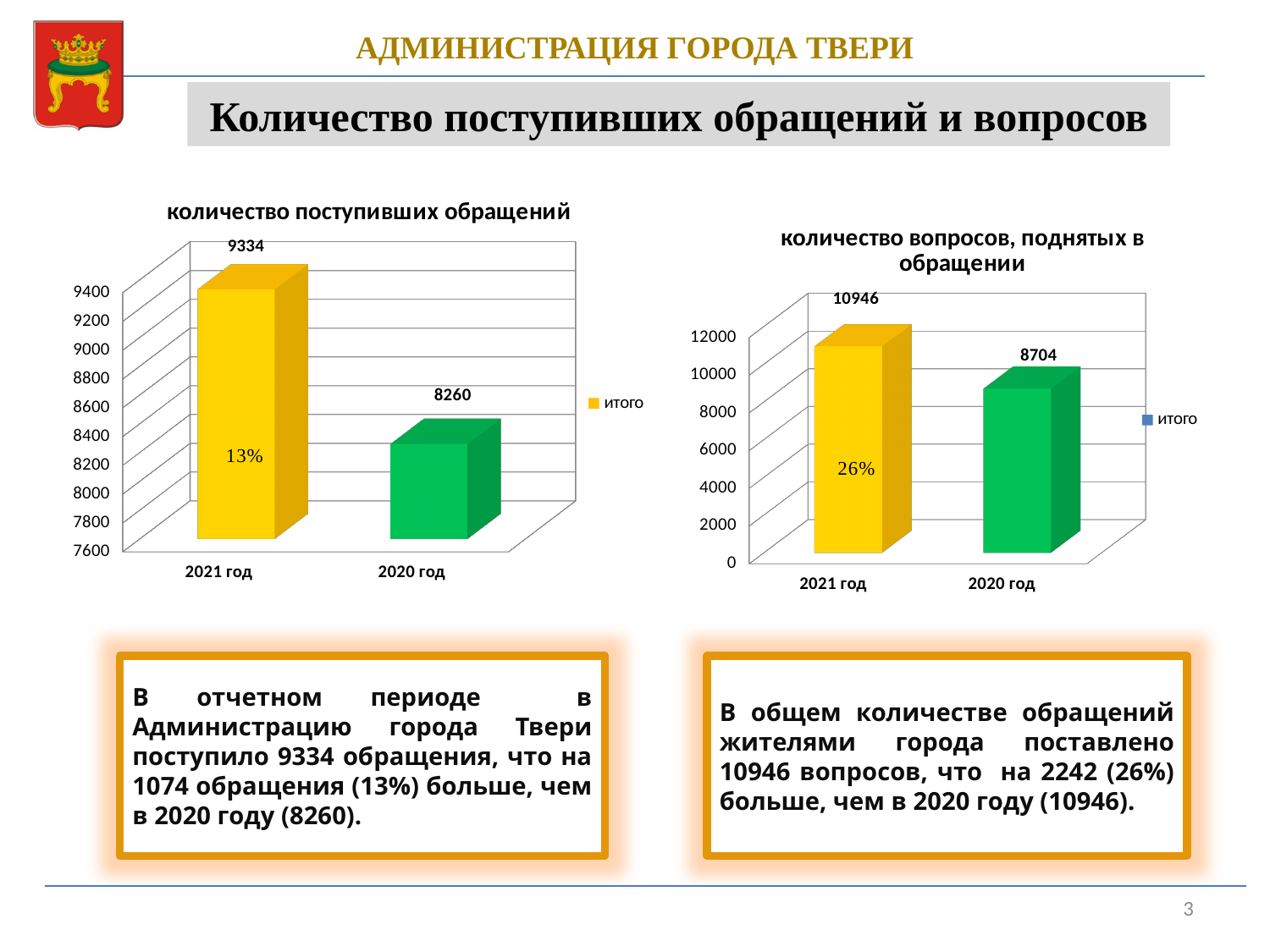
In the chart titled "количество поступивших обращений", what is the value for 2020 год? 8260 In the chart titled "количество вопросов, поднятых в обращении", what is the value for 2021 год? 10946 In the chart titled "количество вопросов, поднятых в обращении", what is the value for 2020 год? 8704 In the chart titled "количество поступивших обращений", which year has the higher value? 2021 год In the chart titled "количество вопросов, поднятых в обращении", which year has the lower value? 2020 год How many categories are shown in the chart titled "количество поступивших обращений"? 2 In the chart titled "количество поступивших обращений", what is the difference between the values for 2021 год and 2020 год? 1074 What kind of chart is the chart titled "количество вопросов, поднятых в обращении"? bar chart In the chart titled "количество вопросов, поднятых в обращении", is the value for 2020 год greater or less than 10000? less In the chart titled "количество вопросов, поднятых в обращении", what is the difference between the values for 2021 год and 2020 год? 2242 What is the legend entry shown in the chart titled "количество поступивших обращений"? итого In the chart titled "количество поступивших обращений", what is the value for 2021 год? 9334